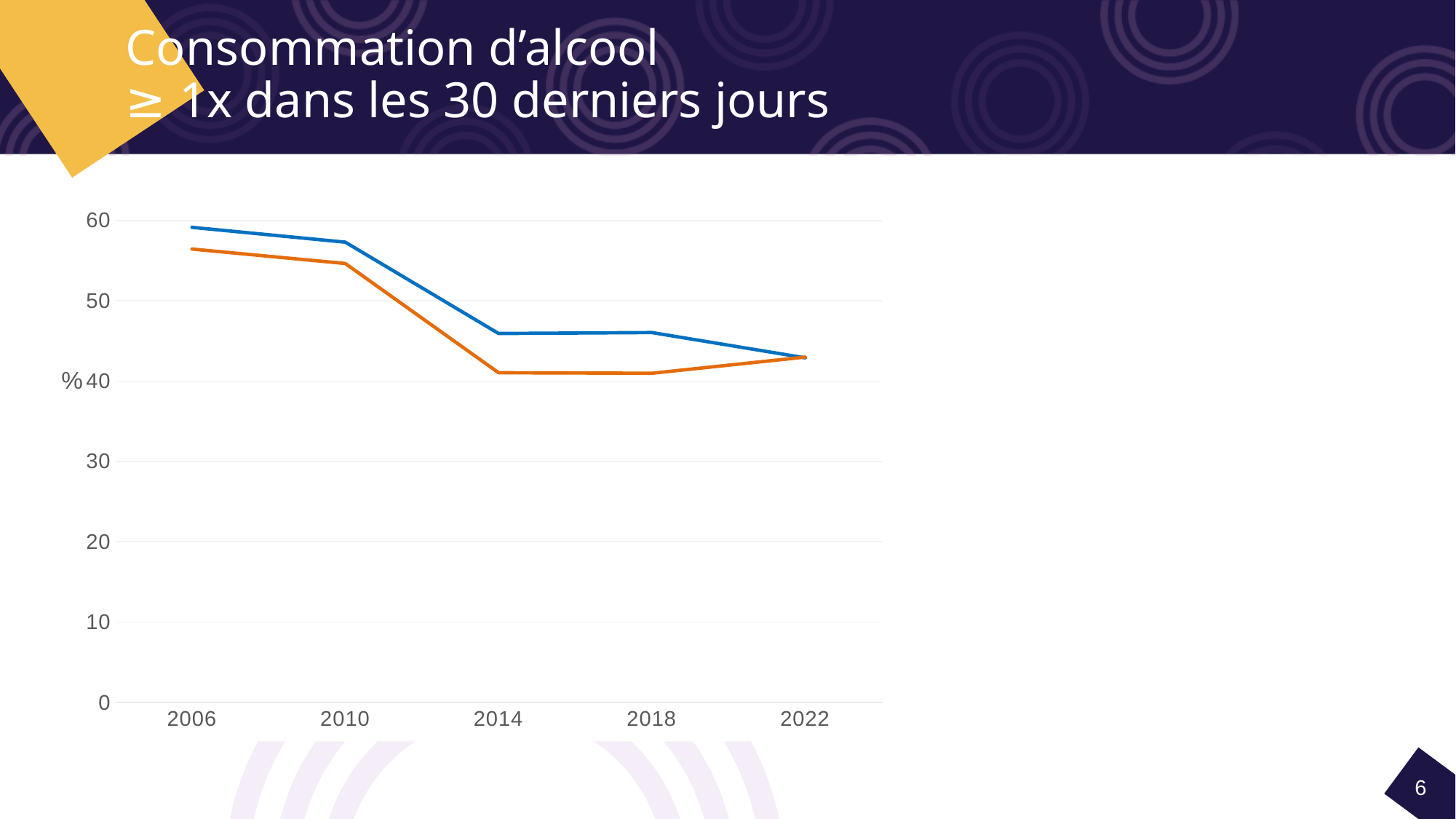
Is the value of the blue line in 2022 greater or less than 40? greater Is the value of the blue line in 2006 greater or less than 50? greater Is the value of the orange line in 2006 greater or less than 50? greater How many years are shown on the x axis of the chart? 5 In 2014, which line has the higher value, the blue line or the orange line? blue line How many lines are plotted on the chart? 2 What is the title of the slide containing the chart? Consommation d'alcool ≥ 1x dans les 30 derniers jours What unit is shown on the y axis of the chart? % Do the values of the blue line generally rise or fall from 2006 to 2022? fall What kind of chart is shown on the slide? line chart In which year does the blue line reach its lowest value? 2022